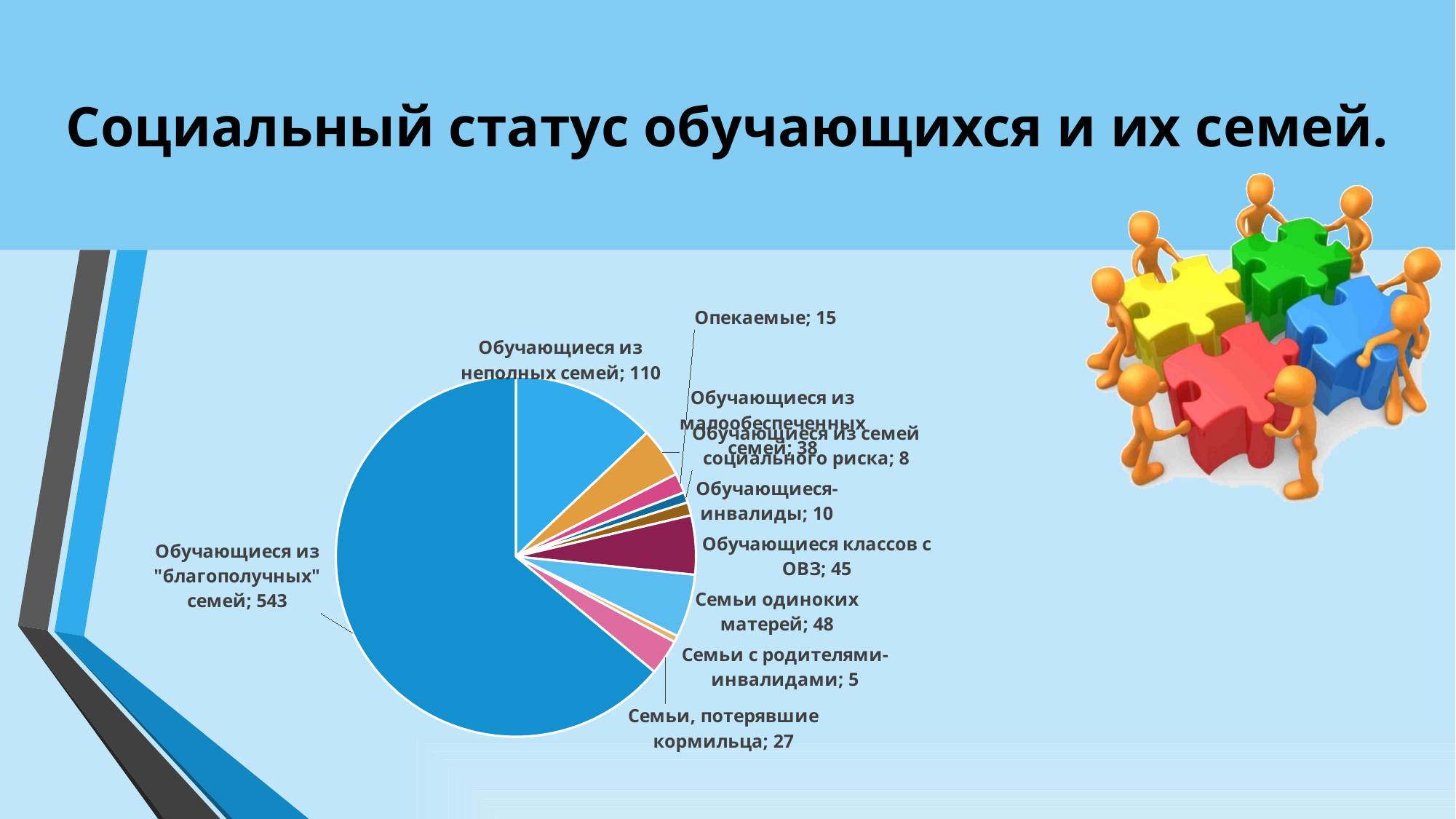
What is the difference between Обучающиеся из неполных семей and Семьи одиноких матерей? 62 What is the title of the slide containing the chart? Социальный статус обучающихся и их семей. What is the value for Обучающиеся из "благополучных" семей? 543 What is the value for Обучающиеся классов с ОВЗ? 45 Which is larger: Опекаемые or Обучающиеся-инвалиды? Опекаемые What is the value for Обучающиеся из неполных семей? 110 Which category has the smallest value? Семьи с родителями-инвалидами Which category has the largest slice of the pie? Обучающиеся из "благополучных" семей What is the value for Семьи одиноких матерей? 48 What type of chart is shown on the slide? pie chart How many categories are shown in the pie chart? 10 What is the value for Семьи, потерявшие кормильца? 27